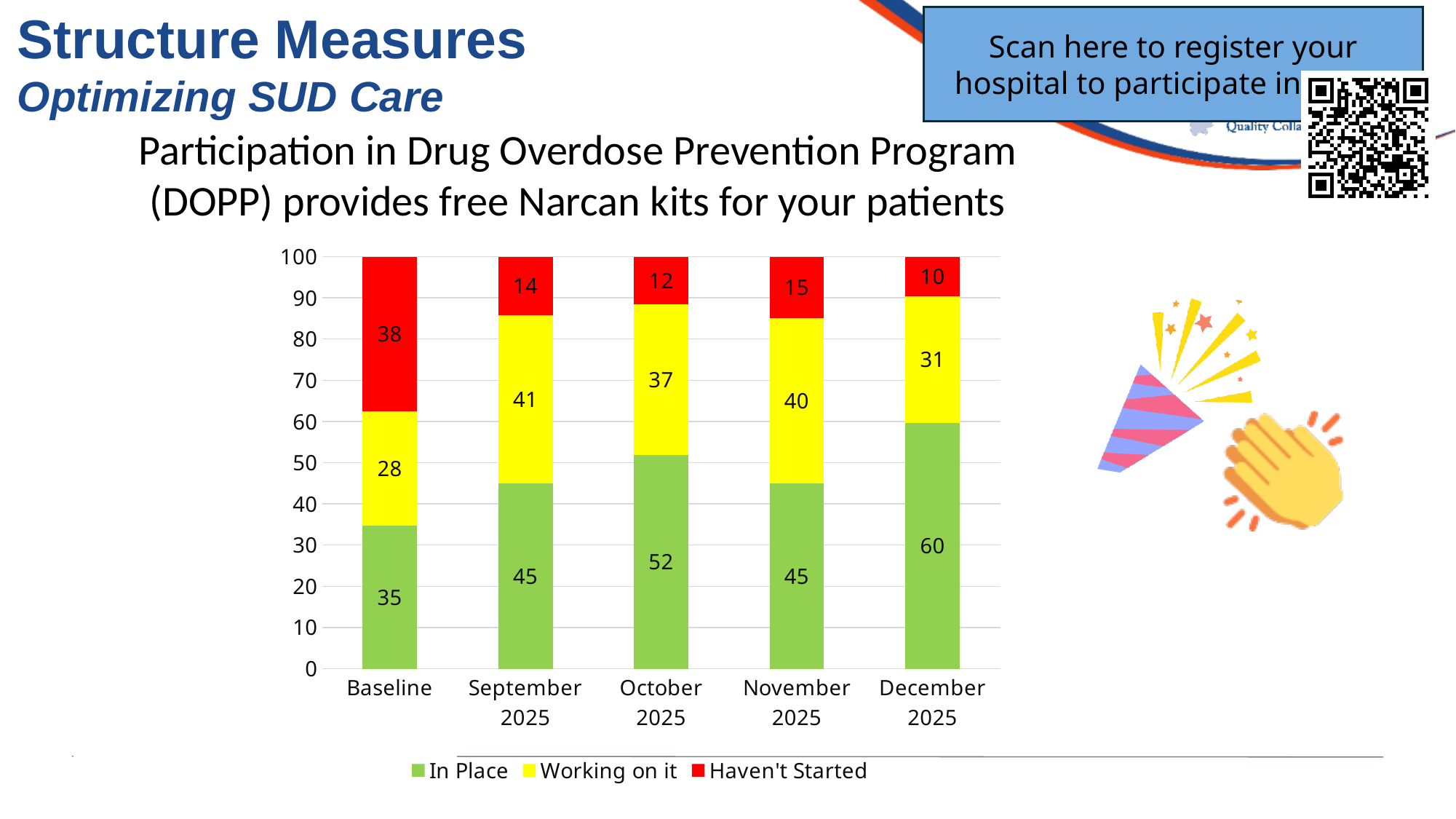
What is the difference between the In Place value for December 2025 and the In Place value for Baseline? 25 What is the total of the stacked bar for September 2025? 100 How many series does the legend list? 3 What is the Working on it value for September 2025? 41 What is the In Place value for December 2025? 60 How many categories are shown on the x axis? 5 Which is larger, the Working on it value for October 2025 or the Working on it value for November 2025? November 2025 What type of chart is shown on the slide? Stacked bar chart Which category has the lowest Haven't Started value? December 2025 What is the Haven't Started value for Baseline? 38 Which category has the highest In Place value? December 2025 Which series is shown in red in the legend? Haven't Started